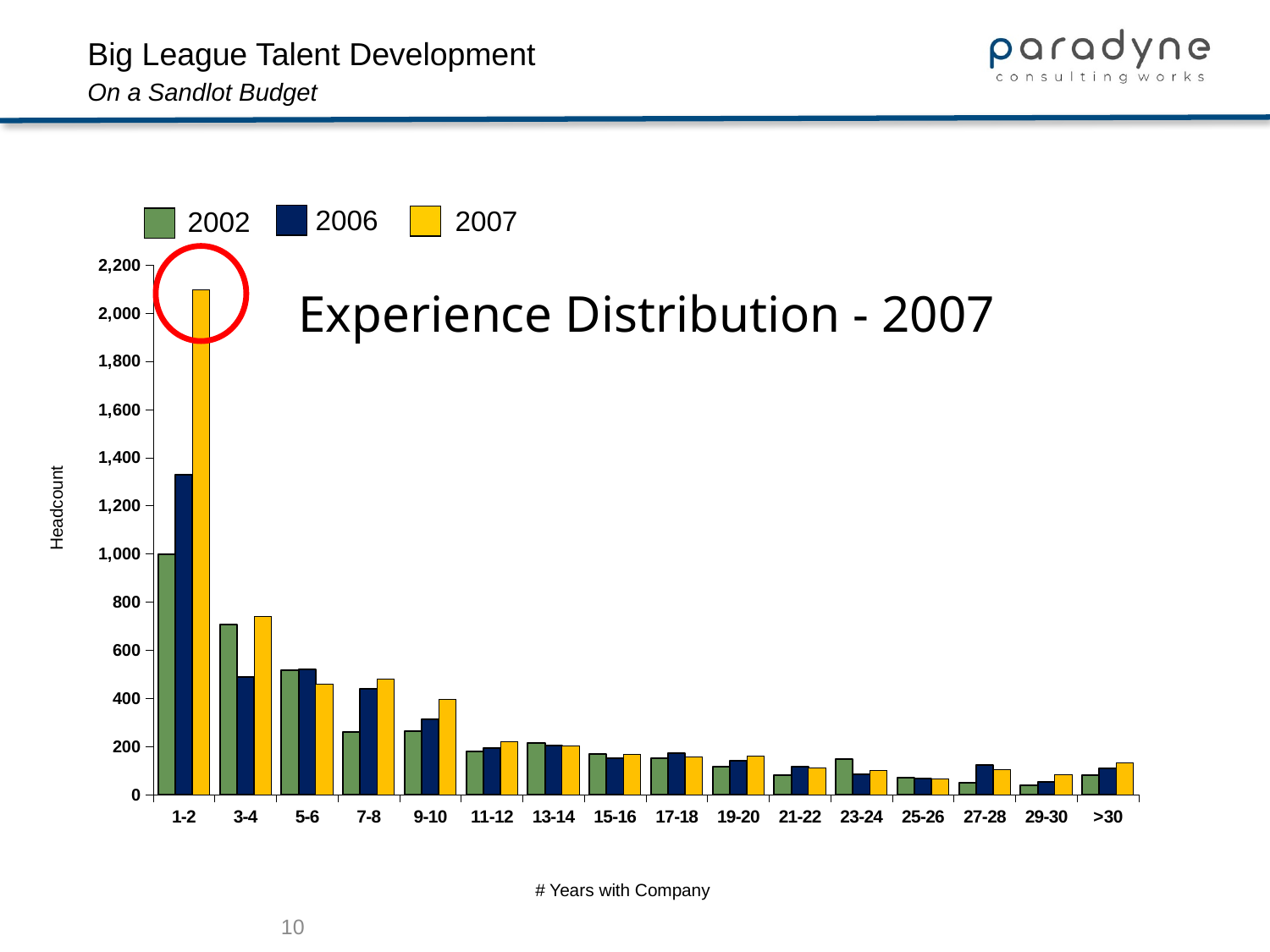
Is the 2006 value for the 1-2 category greater or less than 1,200? greater Is the 2002 value for the 3-4 category greater or less than 600? greater What is the title of the chart? Experience Distribution - 2007 How many series does the legend list? 3 Is the 2007 value for the 1-2 category greater or less than 2,000? greater For the 3-4 category, which is larger: the 2002 value or the 2006 value? 2002 For the 2007 series, which is larger: the 7-8 value or the 9-10 value? 7-8 Which category has the highest 2007 headcount? 1-2 What kind of chart is shown on the slide? bar chart How many year-range categories are shown on the x axis? 16 Do the 2007 values generally rise or fall as years with company increase along the x axis? fall For the 7-8 category, which is larger: the 2002 value or the 2007 value? 2007